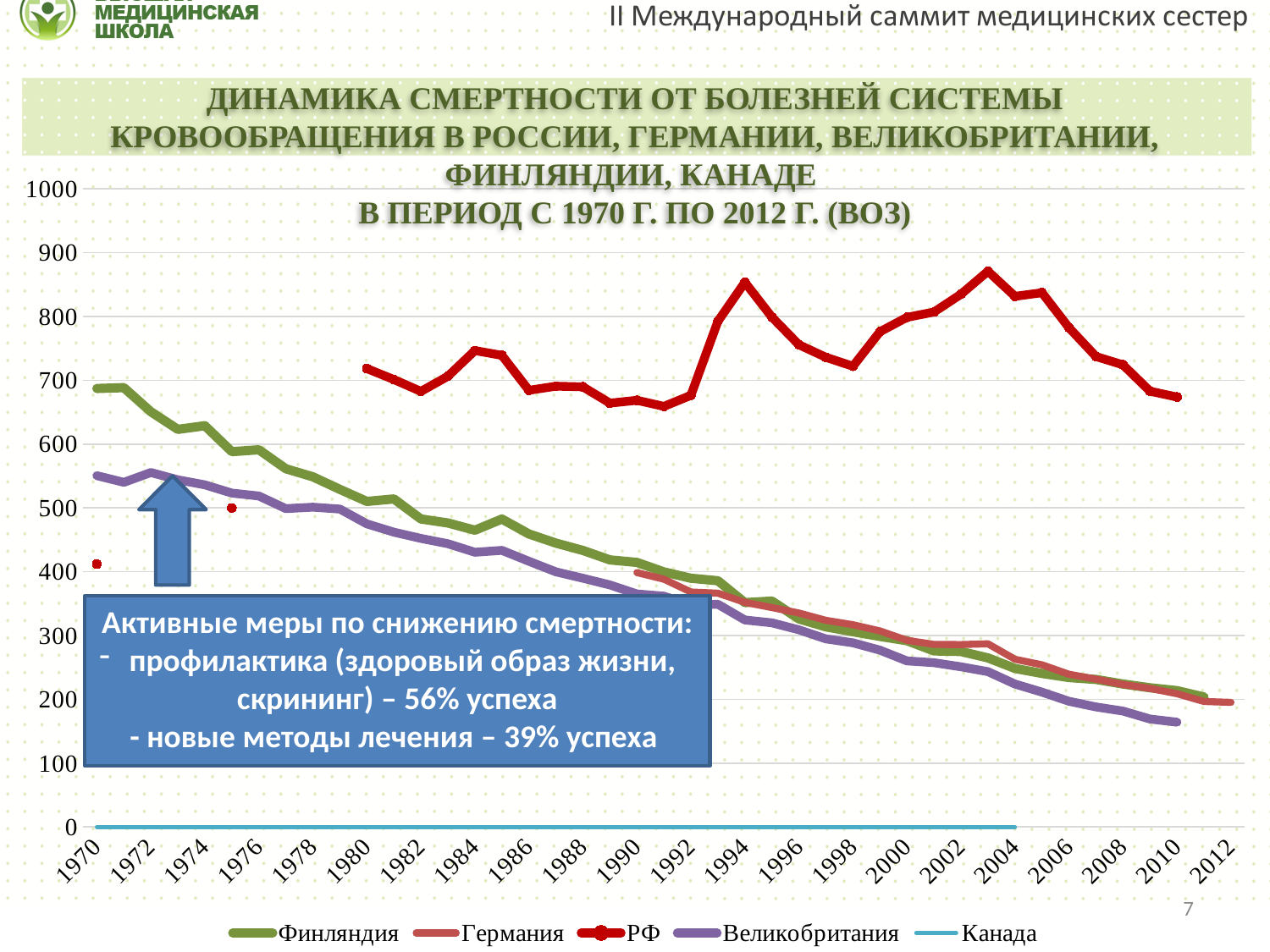
Is the value for Финляндия in 1970 greater or less than 600? greater Which is larger in 1976, the value for Финляндия or the value for Великобритания? Финляндия Is the value for Великобритания in 2010 greater or less than 200? less Which countries are listed in the chart legend? Финляндия, Германия, РФ, Великобритания, Канада Is the value for Германия in 2012 greater or less than 300? less What kind of chart is shown on the slide? line chart Which series has the lowest value in 2000? Канада Does the value for Финляндия rise or fall from 1970 to 2010? fall How many year labels are shown on the x axis? 22 How many series does the legend list? 5 Which series has the highest value in 2000? РФ